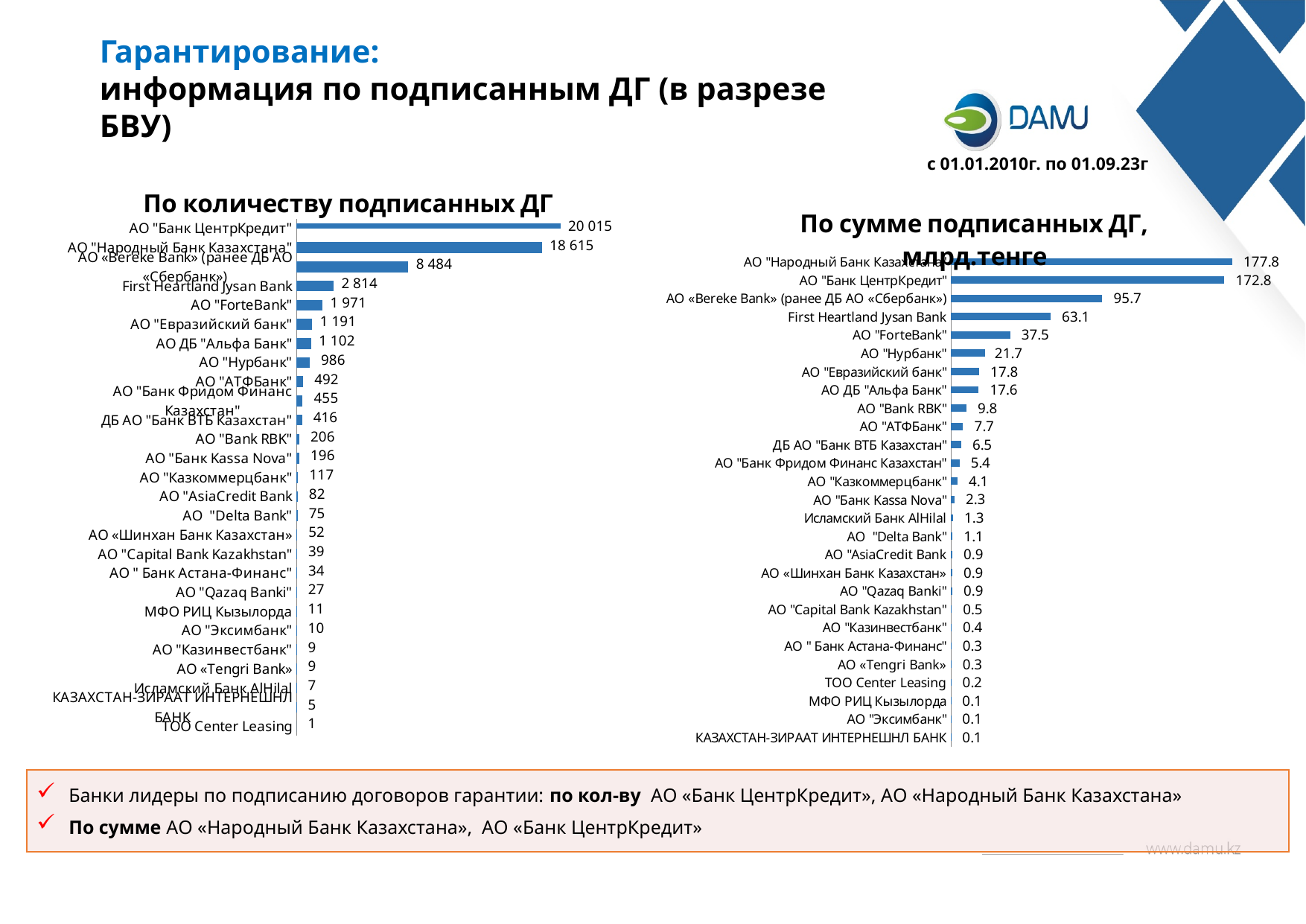
In the chart "По сумме подписанных ДГ, млрд.тенге", what is the value for АО «Bereke Bank» (ранее ДБ АО «Сбербанк»)? 95.7 How many categories are shown in the chart "По сумме подписанных ДГ, млрд.тенге"? 27 In the chart "По количеству подписанных ДГ", what is the value for АО "ForteBank"? 1 971 In the chart "По количеству подписанных ДГ", what is the difference between АО "Банк ЦентрКредит" and АО "Народный Банк Казахстана"? 1 400 In the chart "По сумме подписанных ДГ, млрд.тенге", which is larger: First Heartland Jysan Bank or АО "ForteBank"? First Heartland Jysan Bank In the chart "По сумме подписанных ДГ, млрд.тенге", what is the value for АО "Нурбанк"? 21.7 In the chart "По количеству подписанных ДГ", what is the value for АО "Банк ЦентрКредит"? 20 015 In the chart "По сумме подписанных ДГ, млрд.тенге", what is the difference between АО "Народный Банк Казахстана" and АО "Банк ЦентрКредит"? 5.0 In the chart "По сумме подписанных ДГ, млрд.тенге", which bank has the highest value? АО "Народный Банк Казахстана" In the chart "По количеству подписанных ДГ", which bank has the highest value? АО "Банк ЦентрКредит" In the chart "По количеству подписанных ДГ", which category has the lowest value? ТОО Center Leasing What type of chart is "По количеству подписанных ДГ"? Bar chart